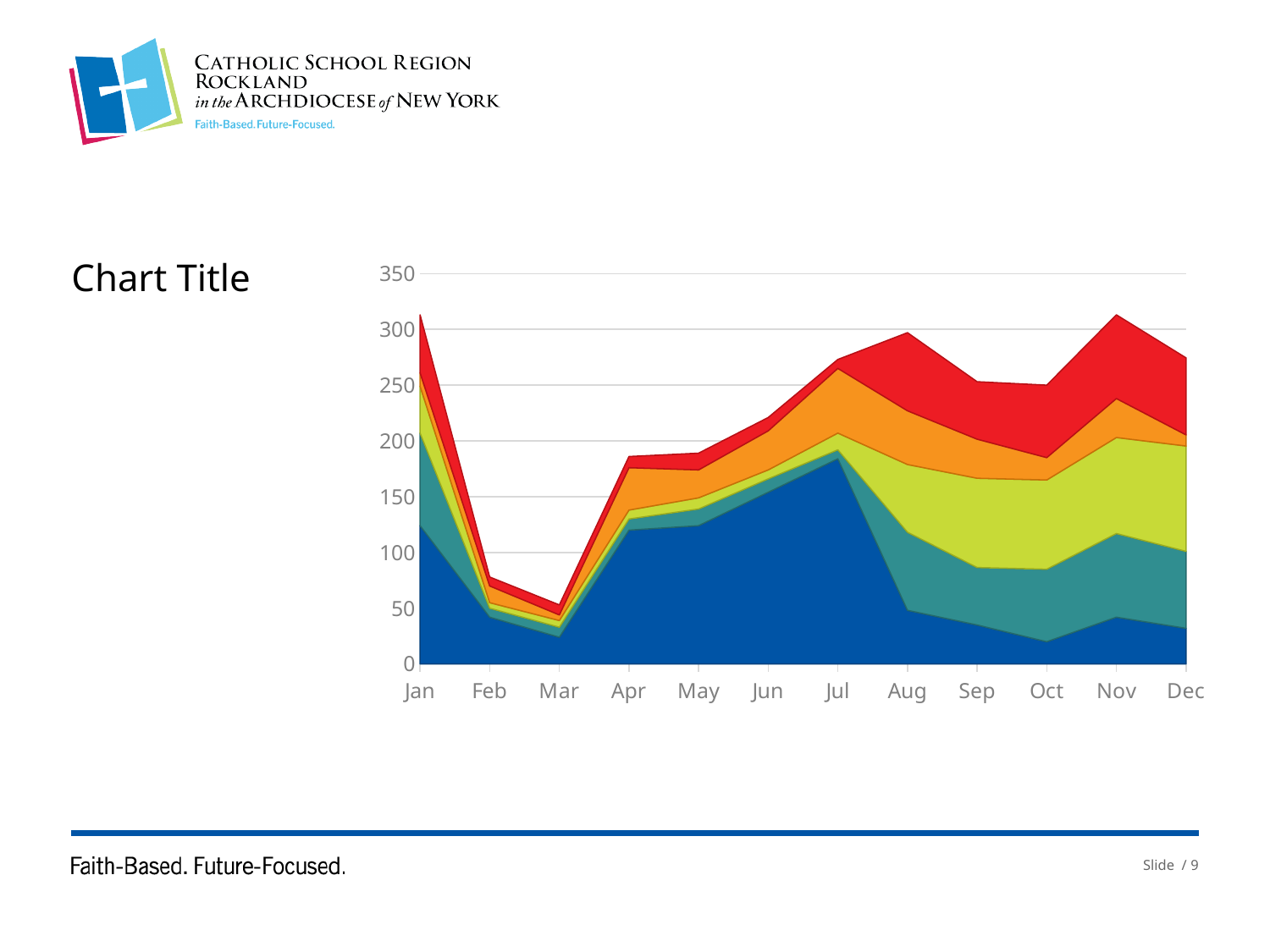
Is the value of the bottom (dark blue) band for Jul greater or less than 150? greater What kind of chart is shown on the slide? stacked area chart Which month has the lowest stacked total in the chart? Mar How many months are shown along the x axis of the chart? 12 What is the title of the chart? Chart Title Do the stacked totals rise or fall from Jan to Mar? fall Is the value of the bottom (dark blue) band for Oct greater or less than 50? less Which has the larger stacked total, Apr or Jul? Jul Is the stacked total for Jul greater or less than 250? greater How many coloured bands are stacked in the chart? 5